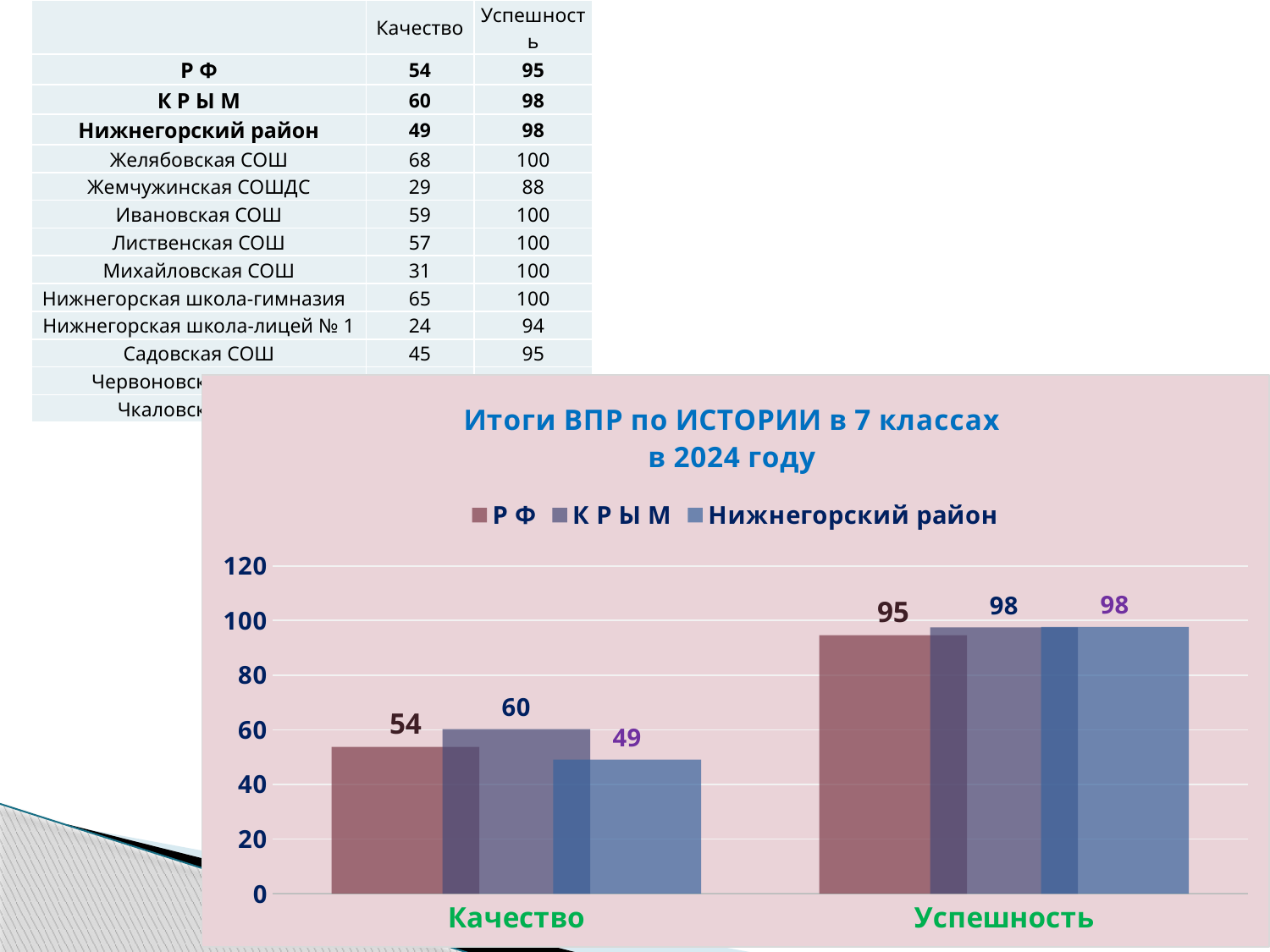
How many series does the legend list? 3 What is the value for Нижнегорский район in the Качество category? 49 What is the value for Р Ф in the Качество category? 54 What kind of chart is shown on the slide? Bar chart Which series has the highest value in the Качество category? К Р Ы М What is the value for Р Ф in the Успешность category? 95 Which series has the lowest value in the Качество category? Нижнегорский район What is the difference between the К Р Ы М and Нижнегорский район values in the Качество category? 11 What is the value for К Р Ы М in the Качество category? 60 What is the title of the chart? Итоги ВПР по ИСТОРИИ в 7 классах в 2024 году What is the value for Нижнегорский район in the Успешность category? 98 Which is larger in the Успешность category: the value for Р Ф or the value for К Р Ы М? К Р Ы М